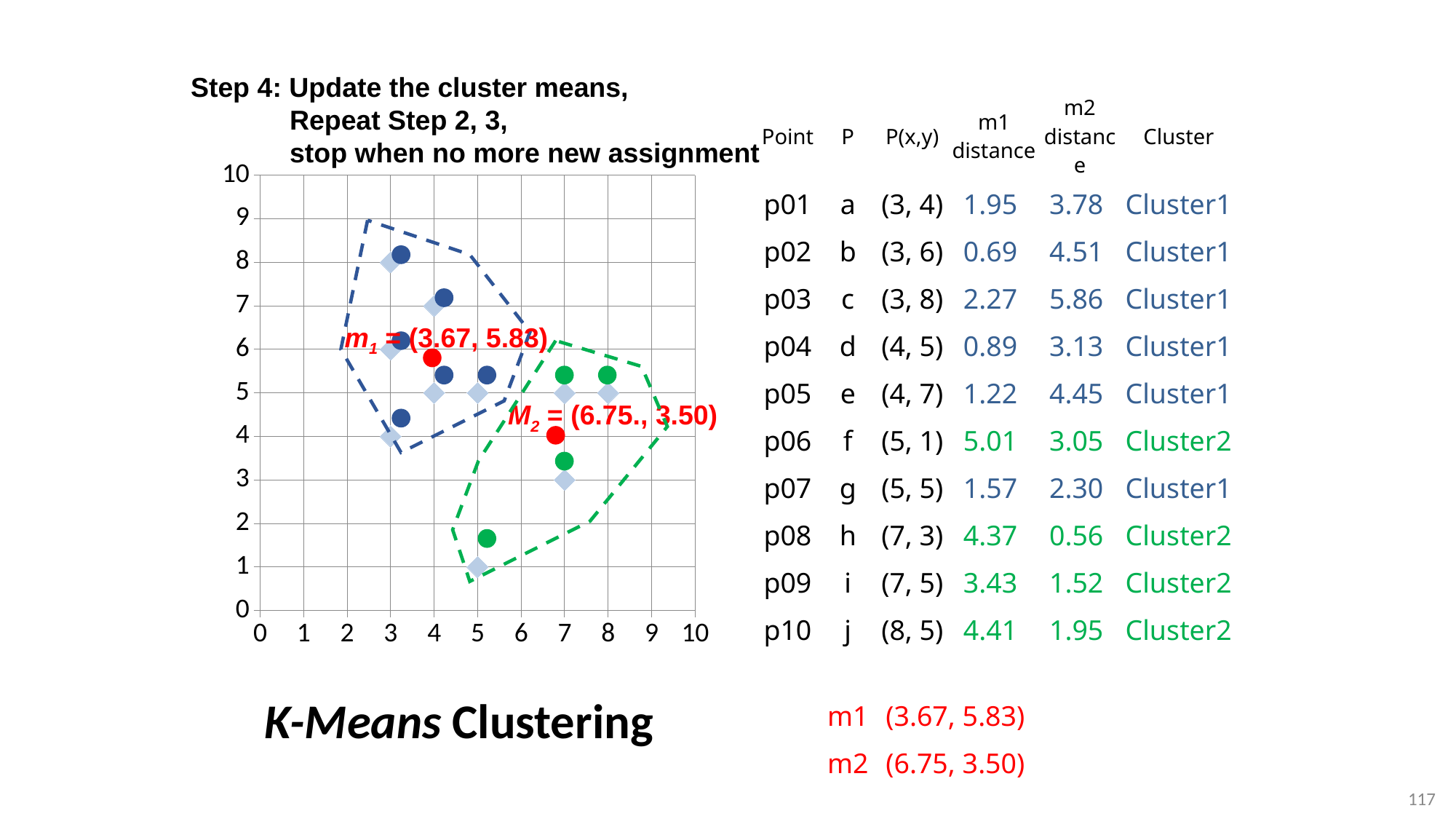
What is the difference between the x coordinates of m2 and m1? 3.08 Is the y coordinate of m2 greater or less than 4? less What kind of chart is shown on the slide? Scatter chart What are the coordinates of the cluster mean m1 labelled on the chart? (3.67, 5.83) What are the coordinates of the cluster mean m2 labelled on the slide? (6.75, 3.50) What colour are the Cluster2 points drawn in on the chart? Green Which point has the highest y value on the chart? c (3, 8) Is the x coordinate of m1 greater or less than 4? less Which cluster mean has the larger x coordinate, m1 or m2? m2 How many data points (a through j) are plotted on the chart? 10 Which point has the lowest y value on the chart? f (5, 1) How many clusters are outlined on the chart? 2